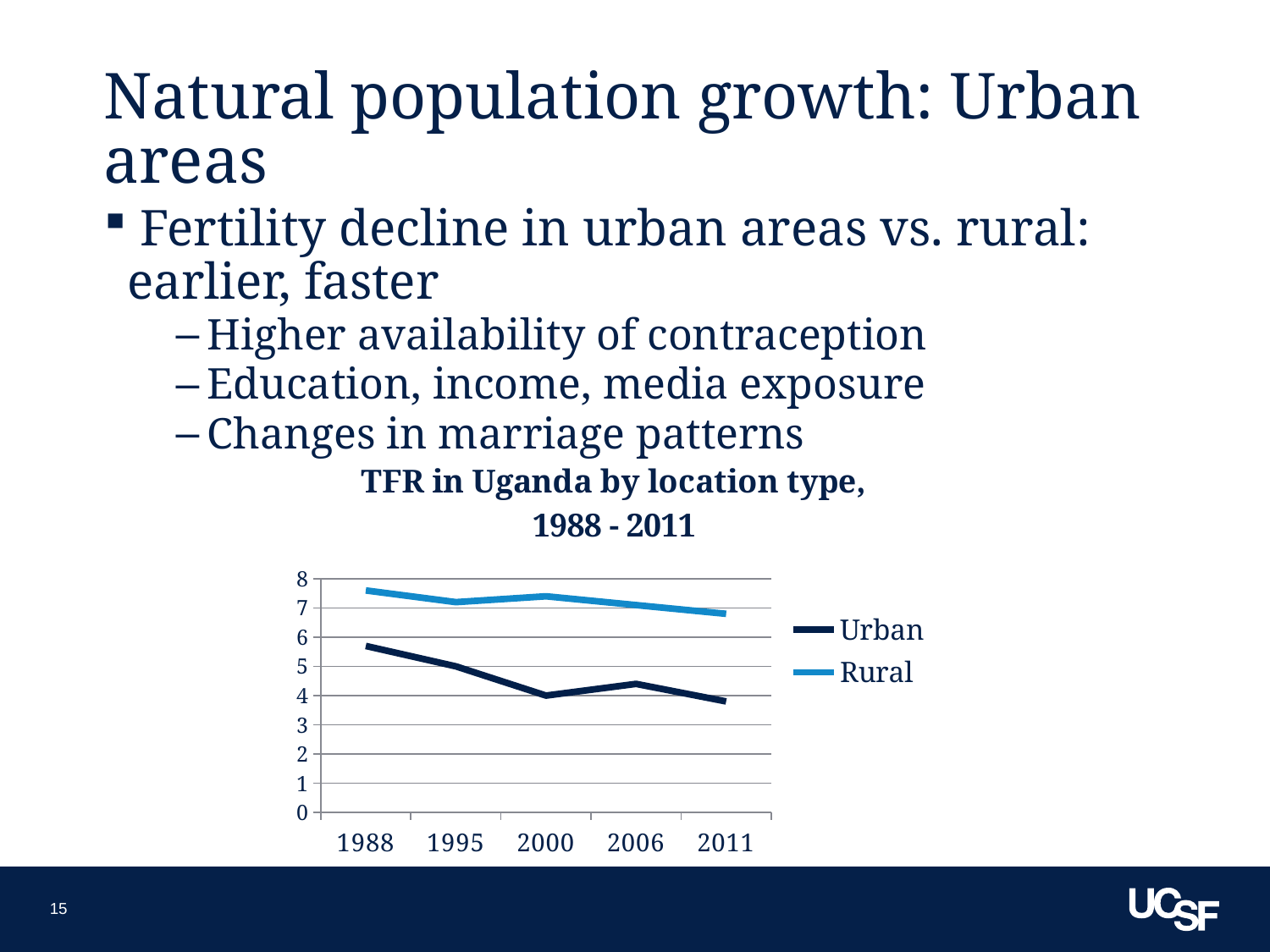
How many series does the legend list? 2 In which year is the Urban series at its highest? 1988 Is the Rural value for 2011 greater or less than 7? less In 1988, which series has the higher value, Urban or Rural? Rural Is the Urban value for 2006 greater or less than 4? greater What is the title of the chart? TFR in Uganda by location type, 1988 - 2011 In which year is the Rural series at its lowest? 2011 How many years are plotted along the x axis? 5 Is the Urban value for 1988 greater or less than 5? greater What kind of chart is shown on the slide? line chart Which series is drawn in the lighter blue line? Rural